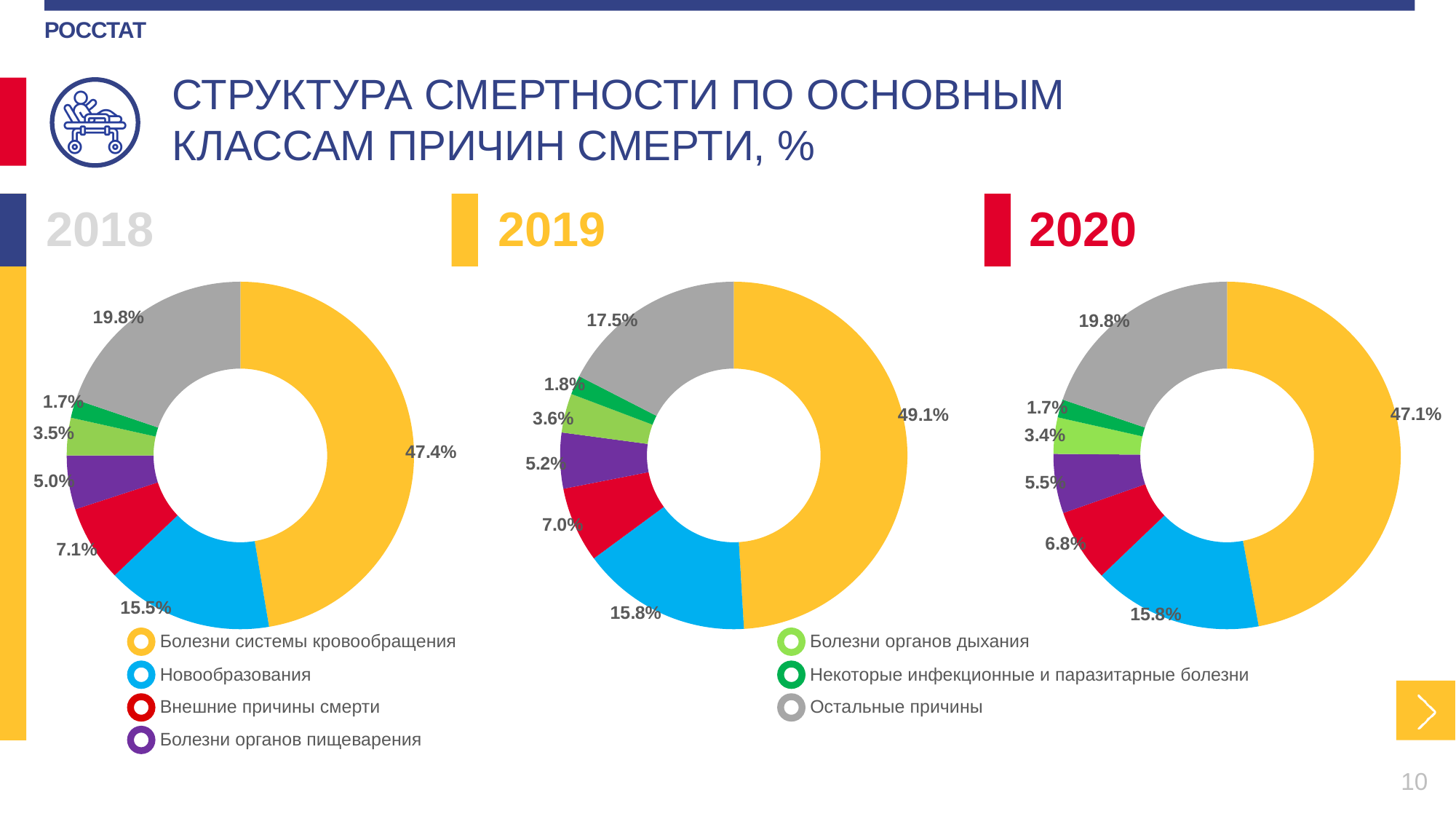
What type of chart is used for each year on this slide? Donut (pie) chart In the 2020 chart, what share is shown for Болезни органов пищеварения? 5.5% In the 2020 chart, what share is shown for Новообразования? 15.8% How many categories does each donut chart show? 7 In the 2019 chart, what share is shown for Остальные причины? 17.5% What is the difference between the share of Болезни системы кровообращения in 2019 and in 2020? 2.0% Which colour represents Новообразования in the charts? Blue How many entries does the legend list? 7 In the 2018 chart, which category has the smallest share? Некоторые инфекционные и паразитарные болезни In the 2018 chart, what share is shown for Болезни системы кровообращения? 47.4% Which is larger: the share of Внешние причины смерти in 2018 or in 2020? 2018 In the 2019 chart, which category has the largest share? Болезни системы кровообращения